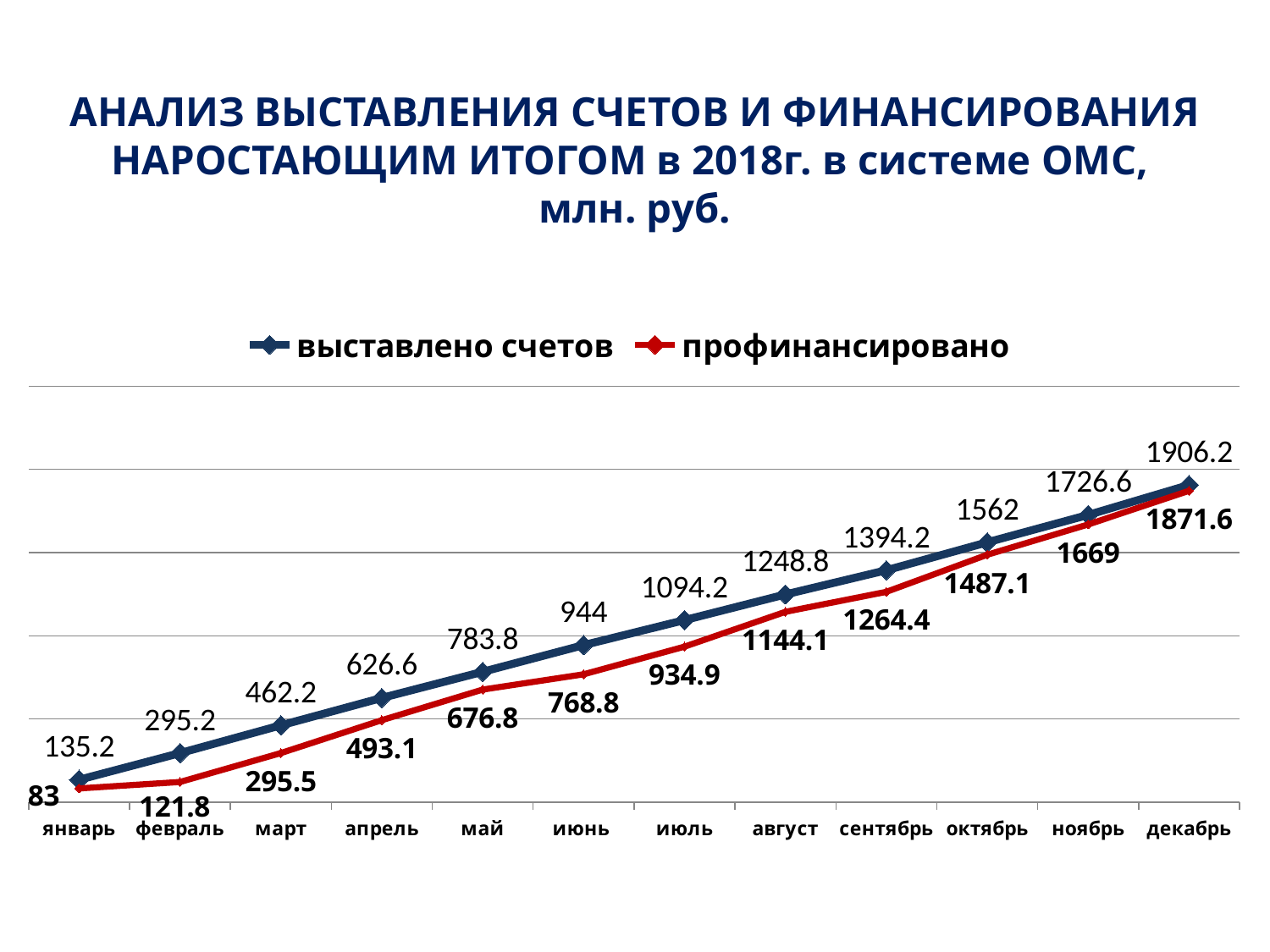
What kind of chart is shown on the slide? line chart What is the value of «выставлено счетов» for декабрь? 1906.2 How many series does the legend list? 2 In which month is «профинансировано» the lowest? январь How many months are shown on the x axis? 12 What is the difference between «выставлено счетов» and «профинансировано» in июнь? 175.2 What is the value of «профинансировано» for январь? 83 What is the value of «профинансировано» for сентябрь? 1264.4 In which month is «выставлено счетов» the highest? декабрь Which is larger in март: «выставлено счетов» or «профинансировано»? выставлено счетов What is the difference between «выставлено счетов» and «профинансировано» in декабрь? 34.6 What is the value of «выставлено счетов» for июнь? 944